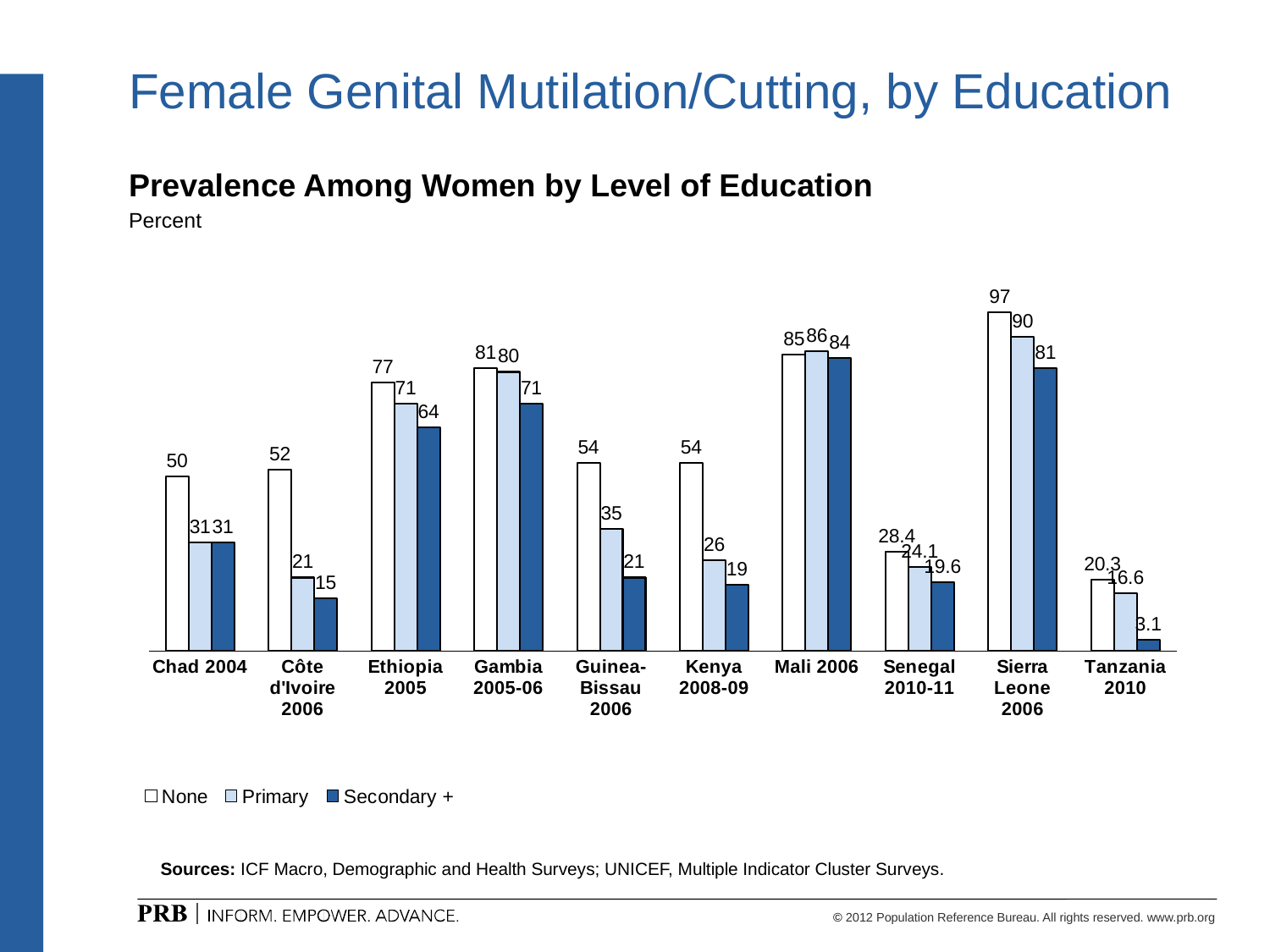
What is the value for the None series for Sierra Leone 2006? 97 How many series does the legend list? 3 Which is larger for Mali 2006, the None value or the Primary value? Primary What is the value for the Primary series for Senegal 2010-11? 24.1 Which country has the highest value for the None series? Sierra Leone 2006 What is the difference between the None and Primary values for Kenya 2008-09? 28 How many countries are shown on the x axis? 10 What is the difference between the None and Secondary + values for Côte d'Ivoire 2006? 37 What kind of chart is shown on the slide? Bar chart What is the value for the Secondary + series for Tanzania 2010? 3.1 Which country has the lowest value for the Secondary + series? Tanzania 2010 Which is larger, the Secondary + value for Ethiopia 2005 or the Secondary + value for Gambia 2005-06? Gambia 2005-06